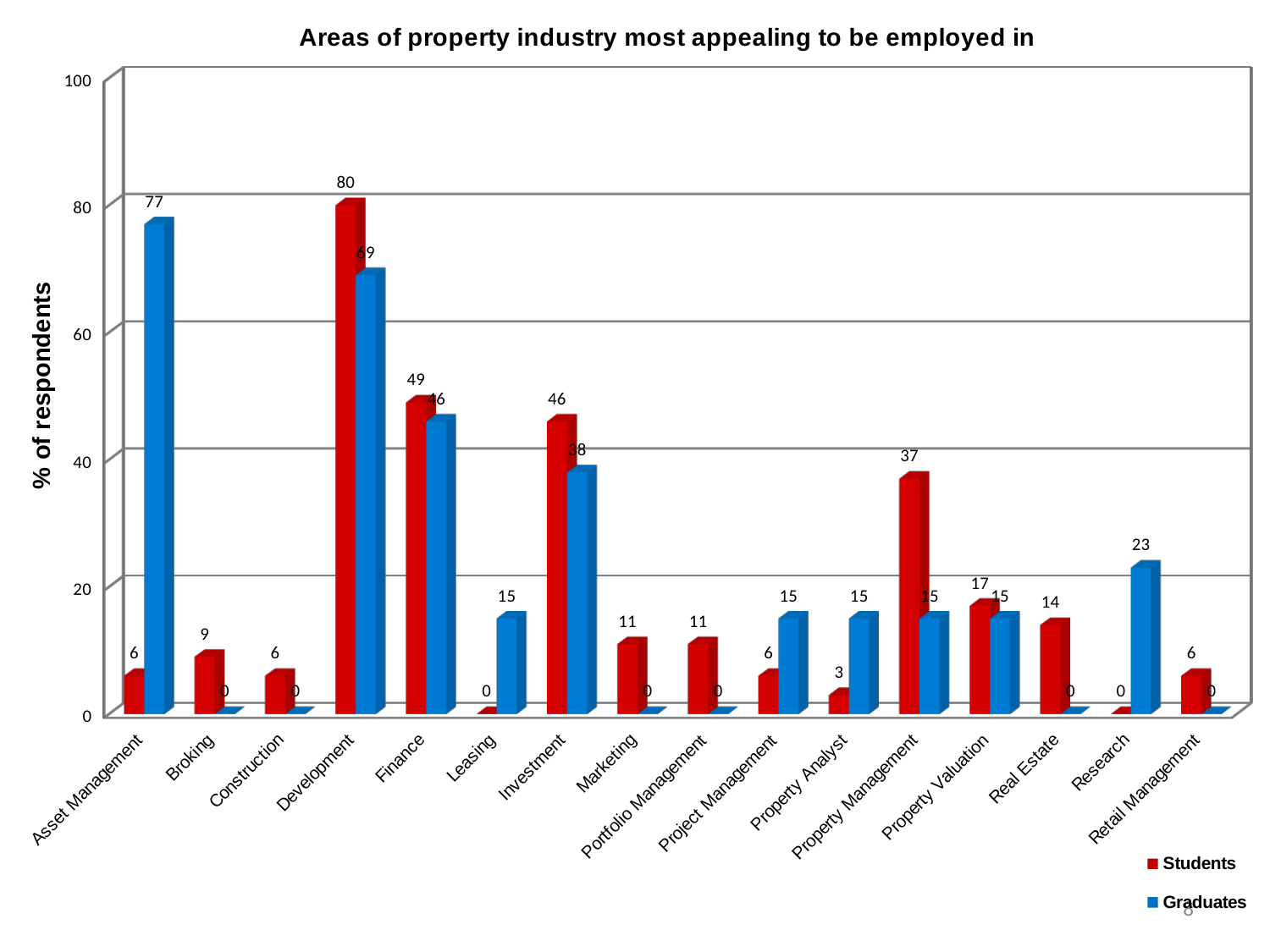
What is the difference between the Students and Graduates values for Investment? 8 What is the Students value for Development? 80 How many categories are shown on the x axis? 16 What kind of chart is shown on the slide? Bar chart Which category has the highest Students value? Development What is the Students value for Property Management? 37 How many series does the legend list? 2 What is the Graduates value for Asset Management? 77 Which category has the highest Graduates value? Asset Management Which is larger for Asset Management, the Students value or the Graduates value? Graduates What is the title of the chart? Areas of property industry most appealing to be employed in What is the Graduates value for Research? 23